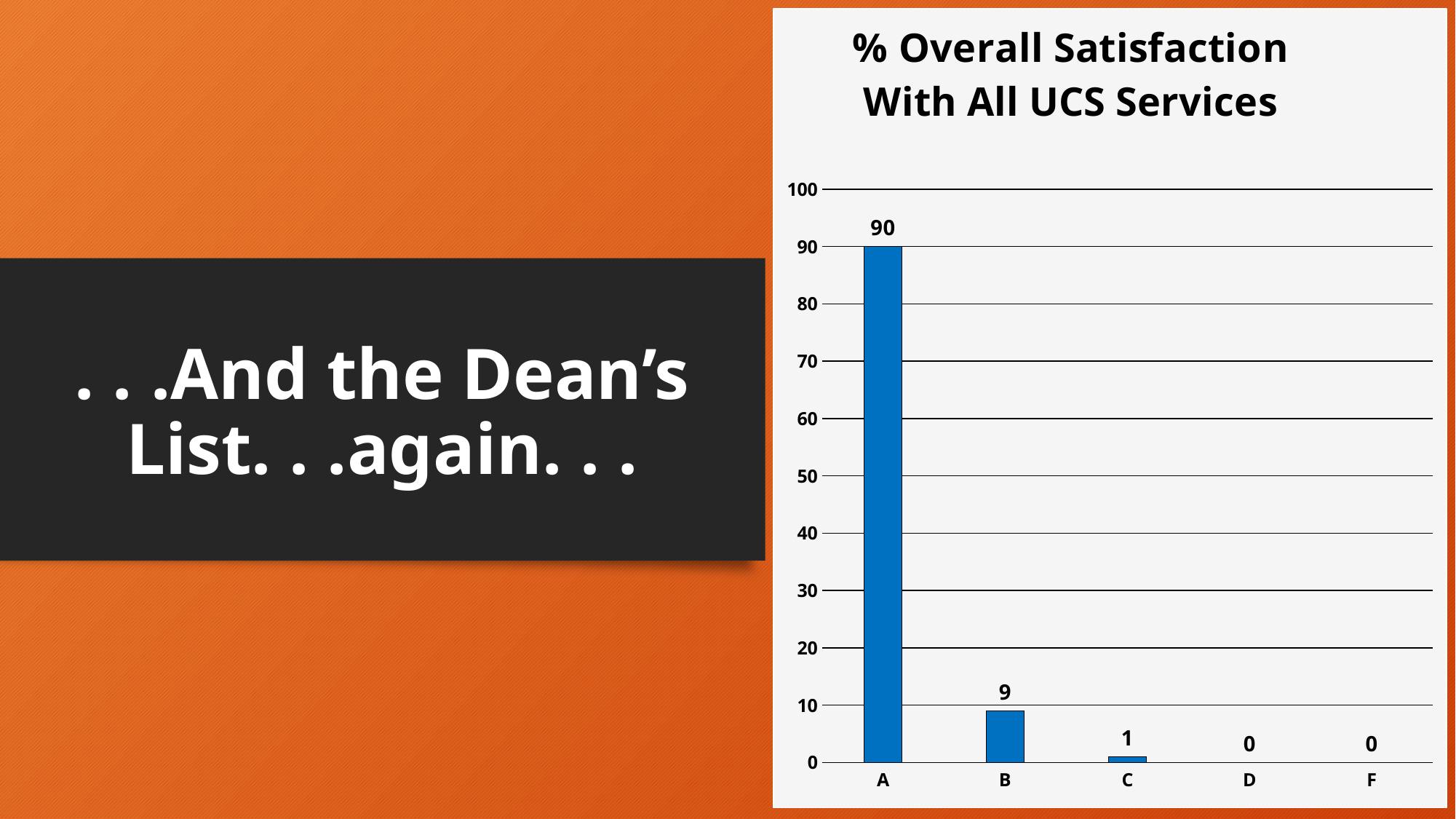
Is the value for A greater or less than 80? greater What is the value for category B? 9 What is the value for category D? 0 How many categories are shown on the x axis? 5 What is the title of the chart? % Overall Satisfaction With All UCS Services What is the value for category C? 1 What is the difference between the values for A and B? 81 Do the values rise or fall from A to F along the x axis? fall Which category has the highest value? A Which is larger, the value for B or the value for C? B What kind of chart is shown? bar chart What is the value for category A? 90